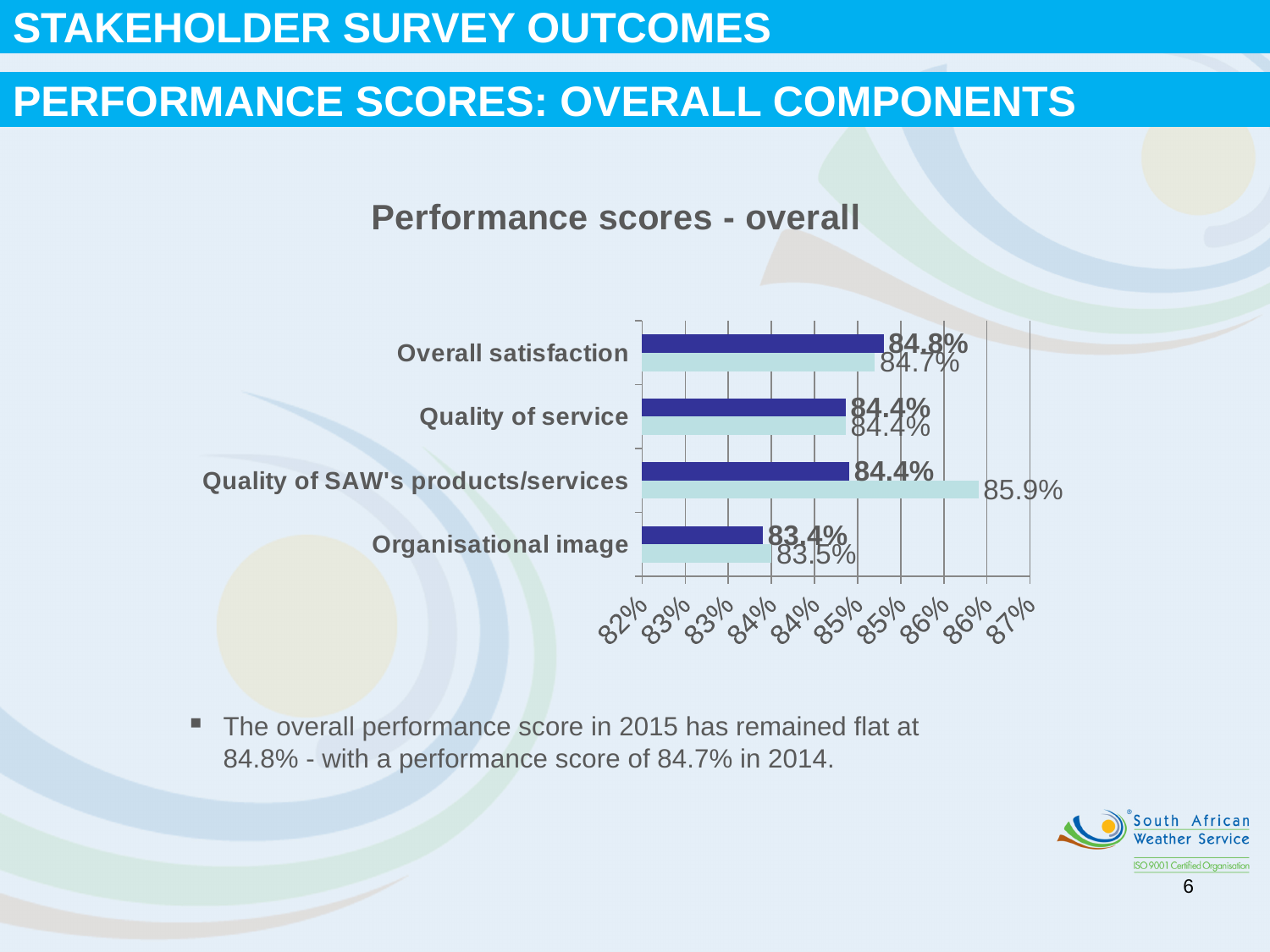
What is the value of the light blue bar for Organisational image? 83.5% For Quality of SAW's products/services, which bar is larger, the dark blue or the light blue? Light blue What is the value of the light blue bar for Quality of SAW's products/services? 85.9% How many categories are shown on the chart? 4 Which category has the highest light blue bar? Quality of SAW's products/services What is the value of the light blue bar for Overall satisfaction? 84.7% What is the title of the chart? Performance scores - overall What is the difference between the light blue and dark blue bars for Quality of SAW's products/services? 1.5 percentage points What kind of chart is shown on the slide? Bar chart What is the value of the dark blue bar for Organisational image? 83.4% What is the value of the dark blue bar for Overall satisfaction? 84.8% Which category has the lowest dark blue bar? Organisational image